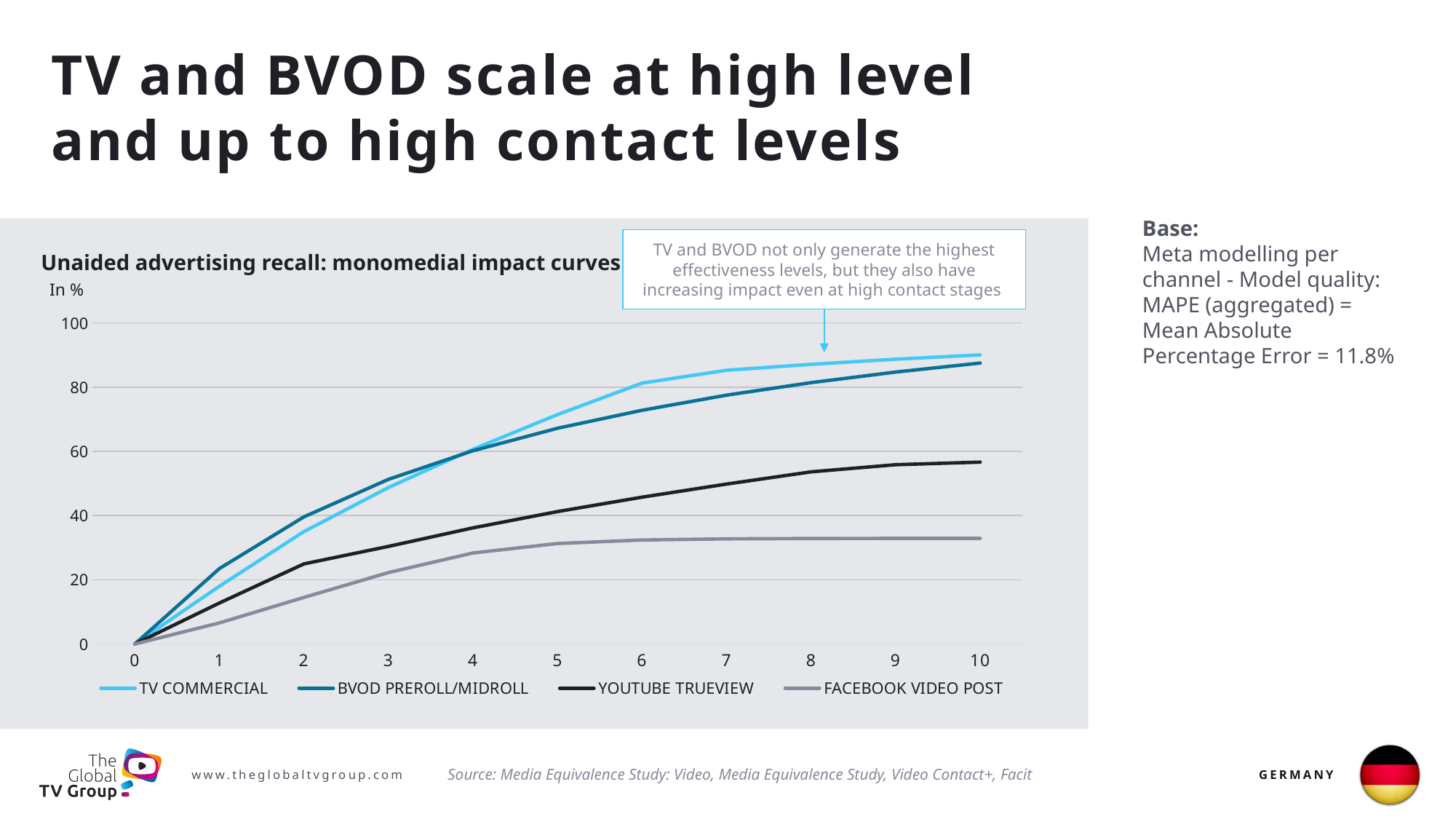
What is the title of the chart? Unaided advertising recall: monomedial impact curves At contact level 10, which is larger: YOUTUBE TRUEVIEW or FACEBOOK VIDEO POST? YOUTUBE TRUEVIEW Is the value for YOUTUBE TRUEVIEW at contact level 10 greater or less than 40? greater How many series does the legend list? 4 Which series has the highest value at contact level 2? BVOD PREROLL/MIDROLL What kind of chart is shown on the slide? Line chart Do the values for TV COMMERCIAL rise or fall as the contact level increases from 0 to 10? Rise Is the value for TV COMMERCIAL at contact level 10 greater or less than 80? greater Is the value for TV COMMERCIAL at contact level 5 greater or less than 60? greater Which series has the lowest value at contact level 10? FACEBOOK VIDEO POST How many contact levels are marked on the x axis? 11